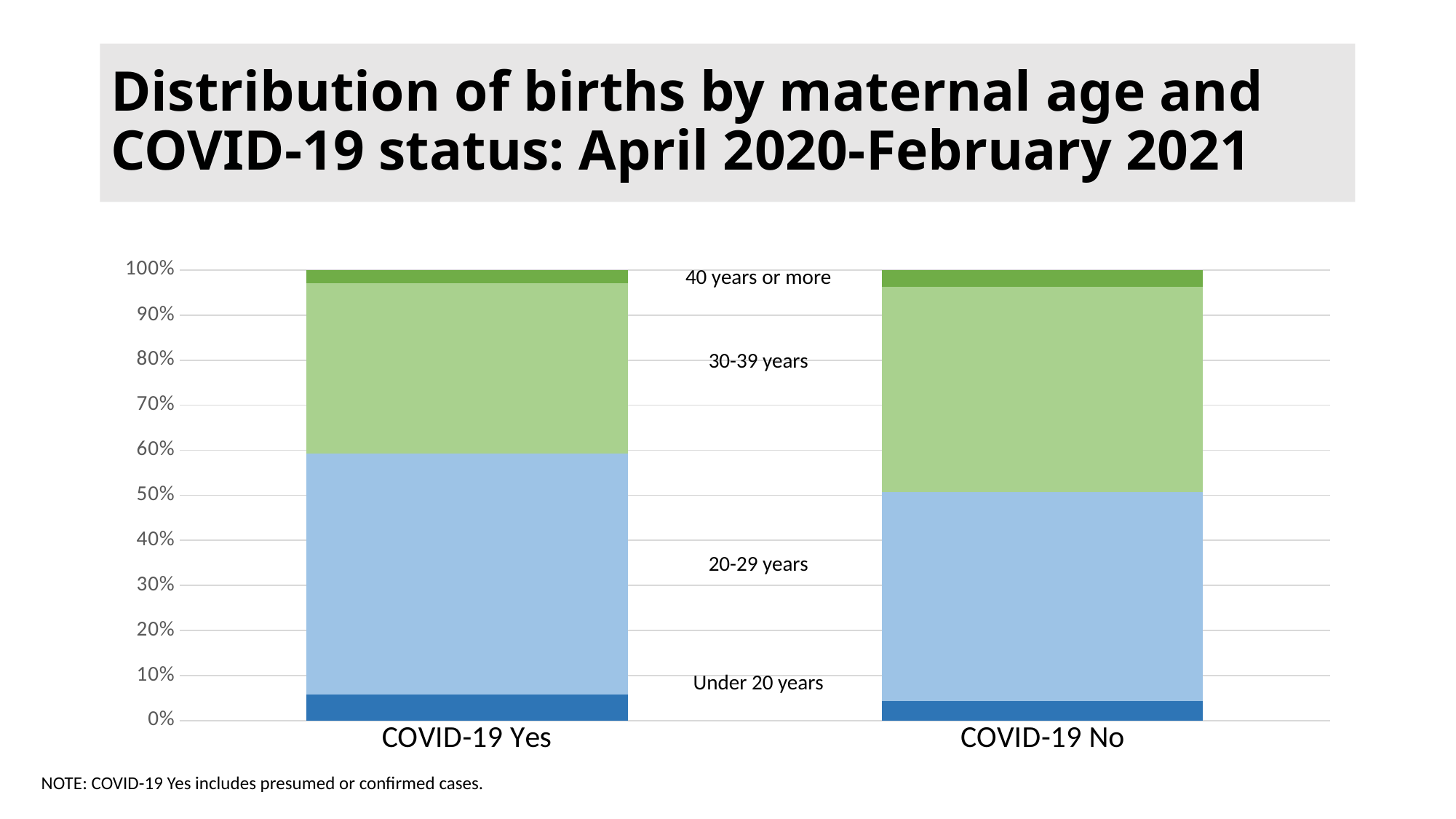
Which age group is shown at the bottom of each stacked bar? Under 20 years Which category has the larger share of births to mothers under 20 years, COVID-19 Yes or COVID-19 No? COVID-19 Yes Is the 40 years or more share for COVID-19 No greater or less than 10%? less What kind of chart is shown on the slide? Stacked bar chart How many maternal age groups (series) are shown in the stacked bars? 4 Which category has the larger share of births to mothers aged 30-39 years, COVID-19 Yes or COVID-19 No? COVID-19 No Is the 20-29 years share for COVID-19 Yes greater or less than 40%? greater What is the title of the chart on the slide? Distribution of births by maternal age and COVID-19 status: April 2020-February 2021 How many COVID-19 status categories are plotted on the x axis? 2 Is the 30-39 years share for COVID-19 No greater or less than 40%? greater Which category has the larger share of births to mothers aged 20-29 years, COVID-19 Yes or COVID-19 No? COVID-19 Yes